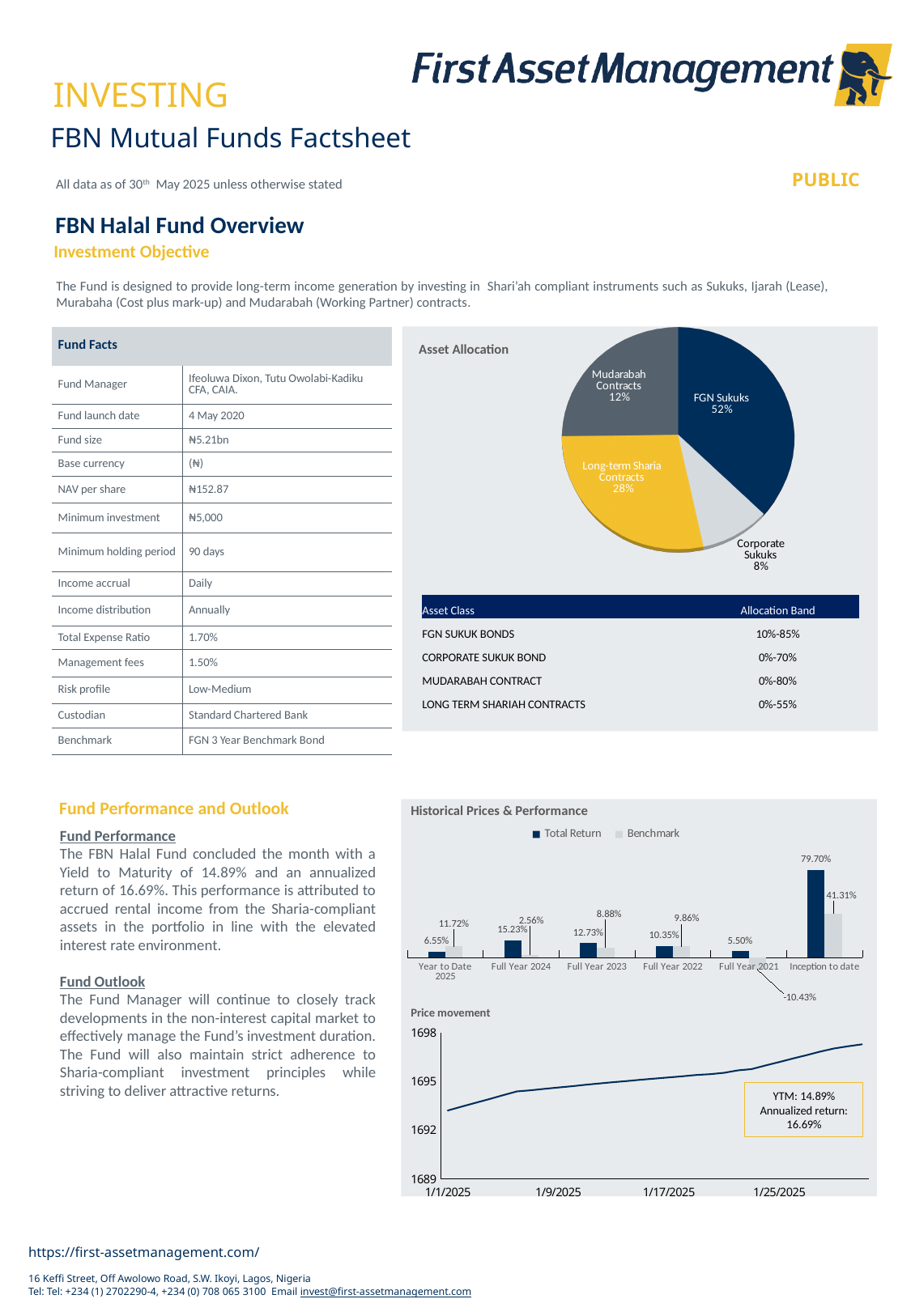
In the Price movement chart, do the values rise or fall from 1/1/2025 to 1/25/2025? Rise In the Asset Allocation pie chart, what is the difference between the Long-term Sharia Contracts share and the Mudarabah Contracts share? 16% In the Historical Prices & Performance chart, what is the Total Return for Full Year 2024? 15.23% In the Historical Prices & Performance chart, how many series does the legend list? 2 In the Historical Prices & Performance chart, which is larger for Year to Date 2025: Total Return or Benchmark? Benchmark In the Asset Allocation pie chart, how many slices are there? 4 In the Historical Prices & Performance chart, which category has the highest Total Return? Inception to date In the Historical Prices & Performance chart, what is the Benchmark value for Full Year 2021? -10.43% In the Historical Prices & Performance chart, what is the difference between Total Return and Benchmark for Inception to date? 38.39% In the Asset Allocation pie chart, what share is FGN Sukuks? 52% In the Asset Allocation pie chart, which asset class has the smallest slice? Corporate Sukuks What kind of chart is the Price movement chart? Line chart